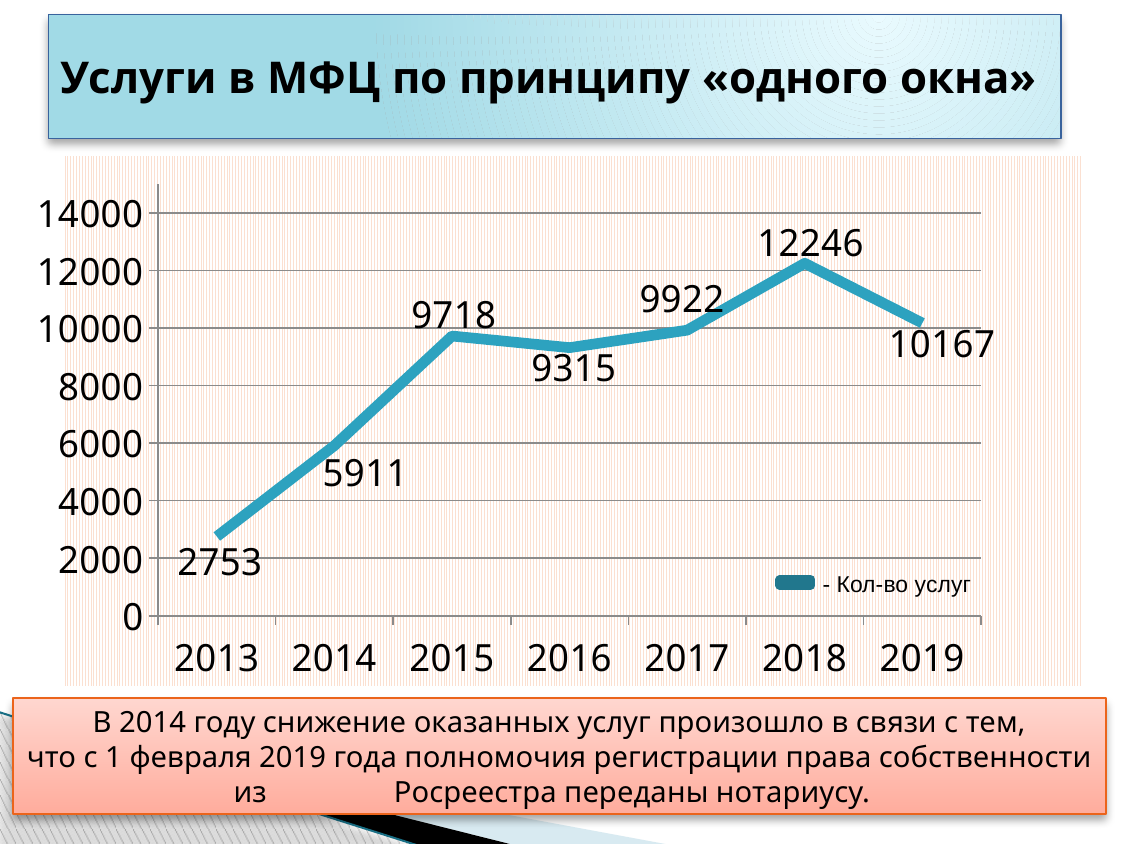
What is the value for 2013? 2753 Which year has the lowest value? 2013 Which year has the highest value? 2018 What is the difference between the values for 2018 and 2019? 2079 What kind of chart is shown on the slide? line chart What is the value for 2018? 12246 What is the value for 2016? 9315 Is the value for 2017 greater or less than 8000? greater What is the difference between the values for 2014 and 2013? 3158 How many years are plotted on the x axis? 7 Which is larger, the value for 2015 or the value for 2016? 2015 What is the legend entry for the plotted series? - Кол-во услуг